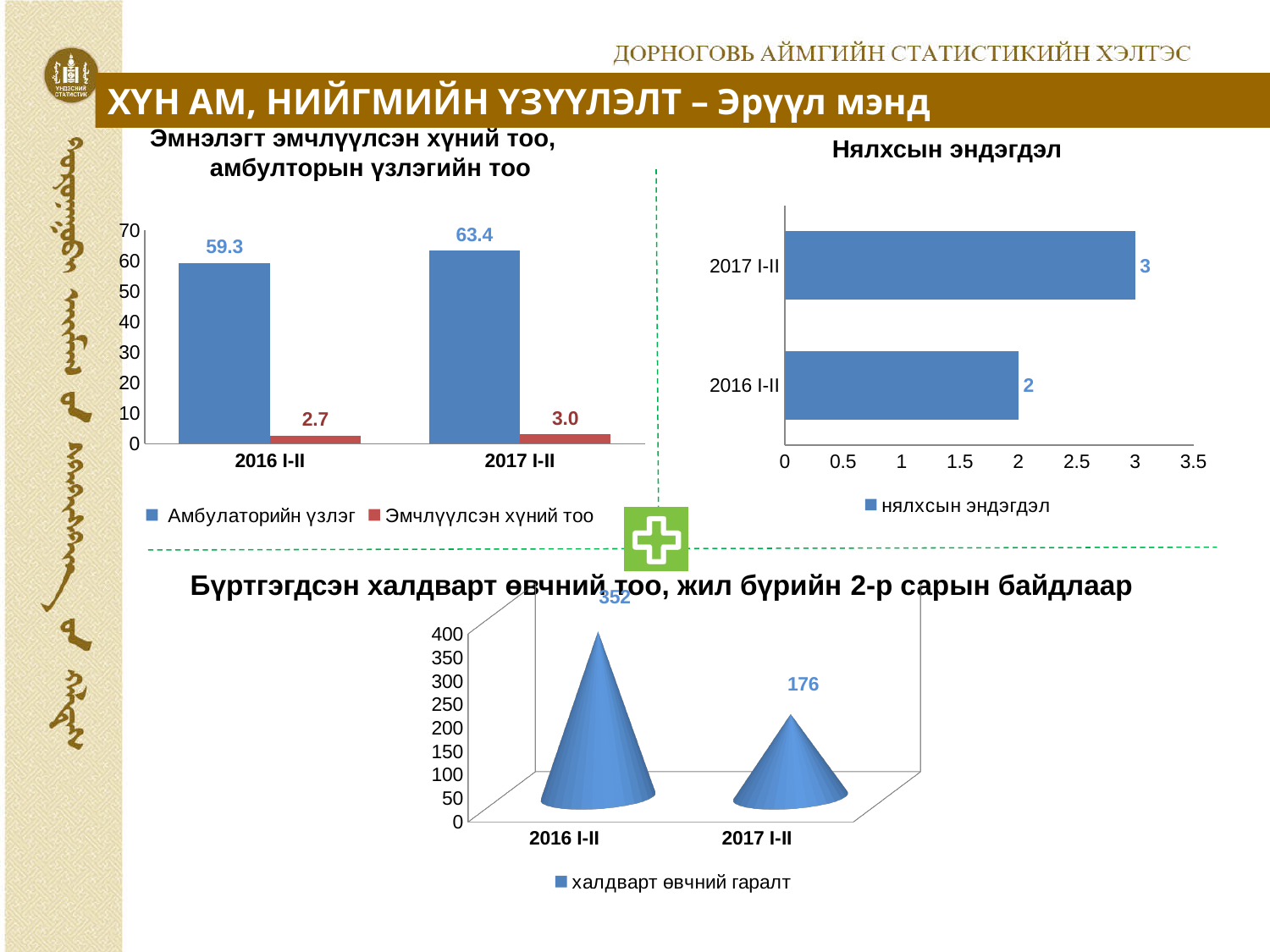
In the top-left chart 'Эмнэлэгт эмчлүүлсэн хүний тоо, амбулторын үзлэгийн тоо', does Амбулаторийн үзлэг rise or fall from 2016 I-II to 2017 I-II? rise In the top-left chart 'Эмнэлэгт эмчлүүлсэн хүний тоо, амбулторын үзлэгийн тоо', what is the value of Амбулаторийн үзлэг for 2016 I-II? 59.3 In the bottom chart 'Бүртгэгдсэн халдварт өвчний тоо, жил бүрийн 2-р сарын байдлаар', which period has the higher value, 2016 I-II or 2017 I-II? 2016 I-II In the bottom chart 'Бүртгэгдсэн халдварт өвчний тоо, жил бүрийн 2-р сарын байдлаар', what is the value for 2016 I-II? 352 In the top-left chart 'Эмнэлэгт эмчлүүлсэн хүний тоо, амбулторын үзлэгийн тоо', how many series does the legend list? 2 In the top-right chart 'Нялхсын эндэгдэл', which period has the lowest value? 2016 I-II In the top-left chart 'Эмнэлэгт эмчлүүлсэн хүний тоо, амбулторын үзлэгийн тоо', what is the value of Эмчлүүлсэн хүний тоо for 2017 I-II? 3.0 In the top-right chart 'Нялхсын эндэгдэл', what is the value for 2017 I-II? 3 In the top-left chart 'Эмнэлэгт эмчлүүлсэн хүний тоо, амбулторын үзлэгийн тоо', by how much did Амбулаторийн үзлэг increase from 2016 I-II to 2017 I-II? 4.1 What kind of chart is the top-right chart 'Нялхсын эндэгдэл'? bar chart In the top-right chart 'Нялхсын эндэгдэл', what is the difference between 2017 I-II and 2016 I-II? 1 In the bottom chart 'Бүртгэгдсэн халдварт өвчний тоо, жил бүрийн 2-р сарын байдлаар', what is the difference between 2016 I-II and 2017 I-II? 176